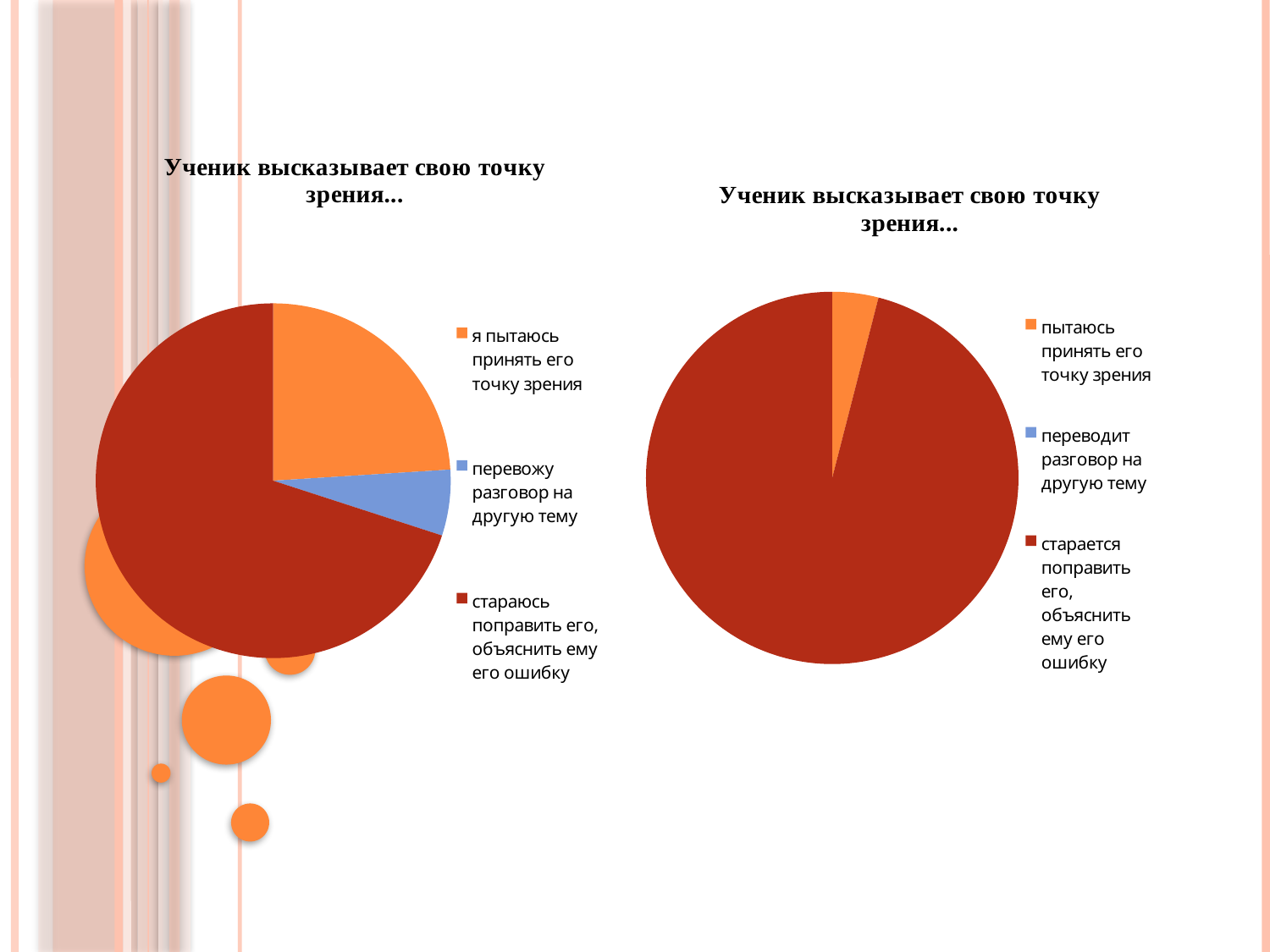
In the right pie chart, which category has the largest slice? старается поправить его, объяснить ему его ошибку In the left pie chart, which category has the smallest slice? перевожу разговор на другую тему In the left pie chart, which category has the largest slice? стараюсь поправить его, объяснить ему его ошибку In the left pie chart, which slice is larger: 'я пытаюсь принять его точку зрения' or 'перевожу разговор на другую тему'? я пытаюсь принять его точку зрения In the right pie chart, what colour is the slice for 'пытаюсь принять его точку зрения'? orange What kind of chart is the left chart on the slide? pie chart How many categories does the legend of the left pie chart list? 3 In the right pie chart, which slice is larger: 'пытаюсь принять его точку зрения' or 'старается поправить его, объяснить ему его ошибку'? старается поправить его, объяснить ему его ошибку What kind of chart is the right chart on the slide? pie chart How many categories does the legend of the right pie chart list? 3 What is the title of the left pie chart? Ученик высказывает свою точку зрения...